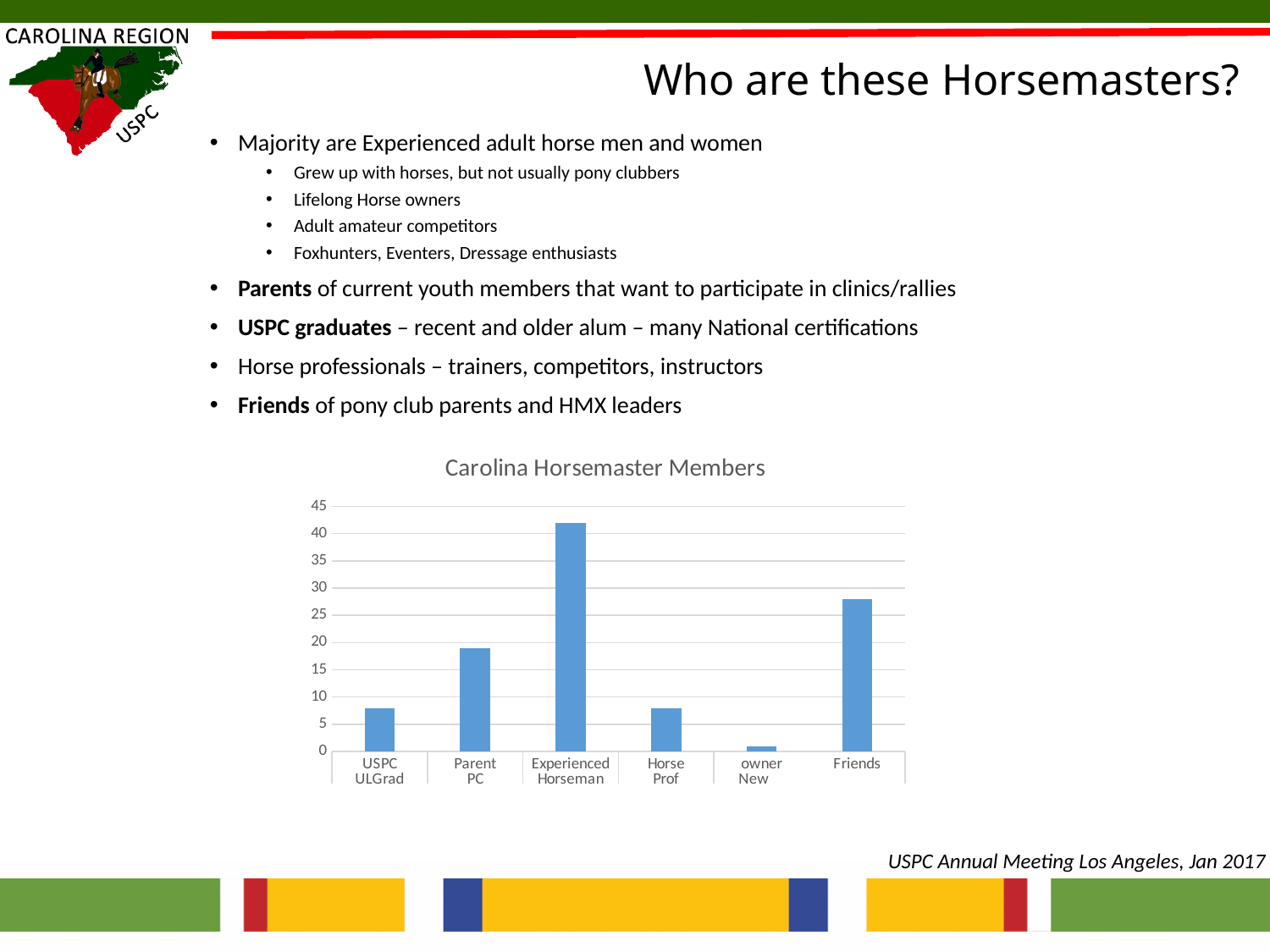
How many categories are shown on the x axis of the chart? 6 Is the value for owner New greater or less than 5? less Is the value for USPC ULGrad greater or less than 10? less Which is larger, the value for Experienced Horseman or the value for Friends? Experienced Horseman What type of chart is shown on the slide? bar chart Which category has the highest value in the chart? Experienced Horseman Is the value for Experienced Horseman greater or less than 40? greater Which category has the lowest value in the chart? owner New Which is larger, the value for Friends or the value for Parent PC? Friends What is the title of the chart? Carolina Horsemaster Members